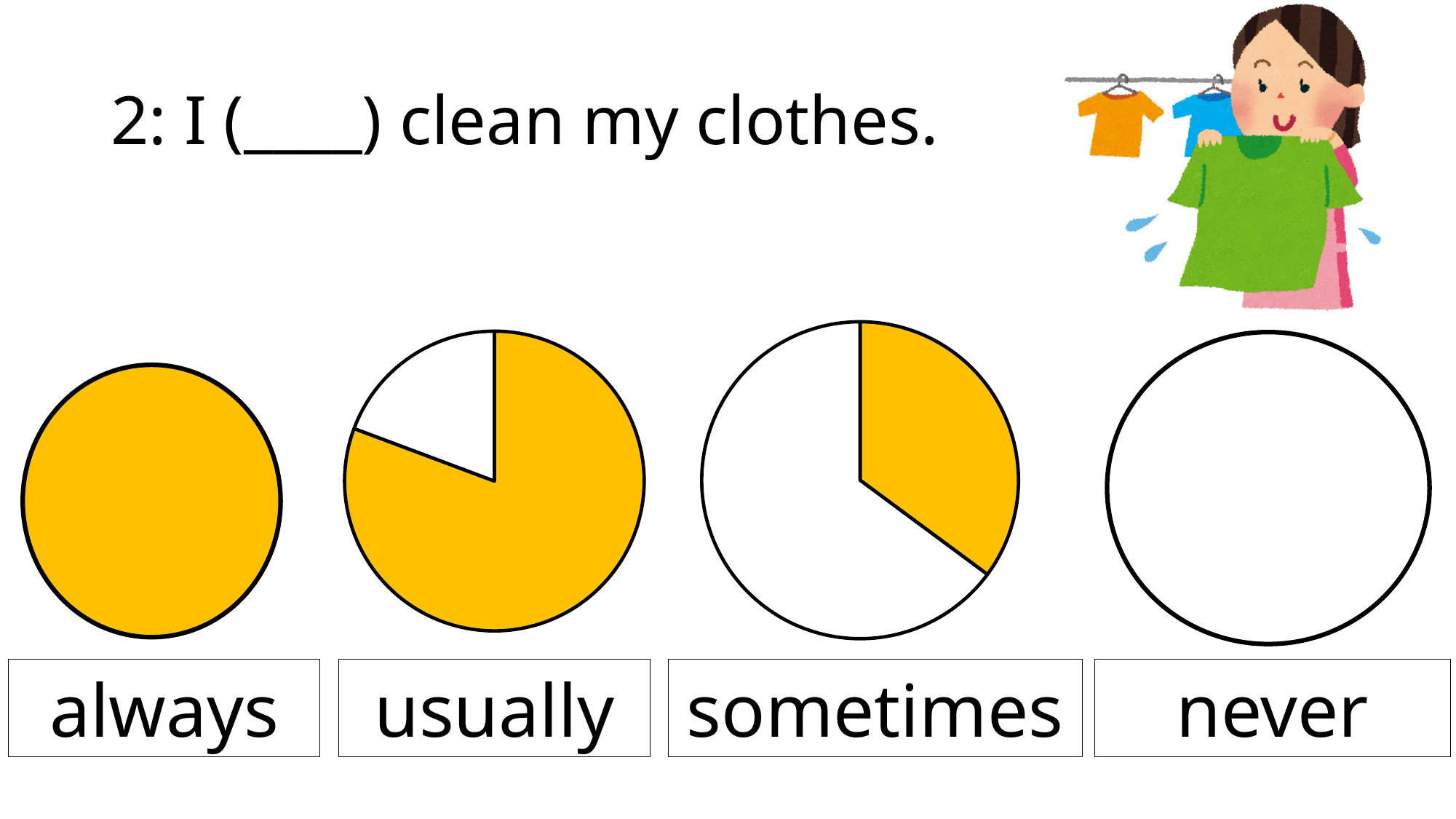
How many pie charts are shown on the slide? 4 Which pie chart has the smallest filled (yellow) share? never What label appears under the pie chart that is completely filled? always Is the filled share of the pie chart labelled usually greater or less than 50%? greater Which pie chart has a larger filled share, the one labelled sometimes or the one labelled never? sometimes Which pie chart has the largest filled (yellow) share? always Which pie chart has a larger filled share, the one labelled usually or the one labelled sometimes? usually What colour is used for the filled portion of the pie charts? yellow Does the filled share of the pie charts rise or fall from left to right across the slide? fall Is the filled share of the pie chart labelled sometimes greater or less than 50%? less What kind of chart is used to show each frequency word on the slide? pie chart